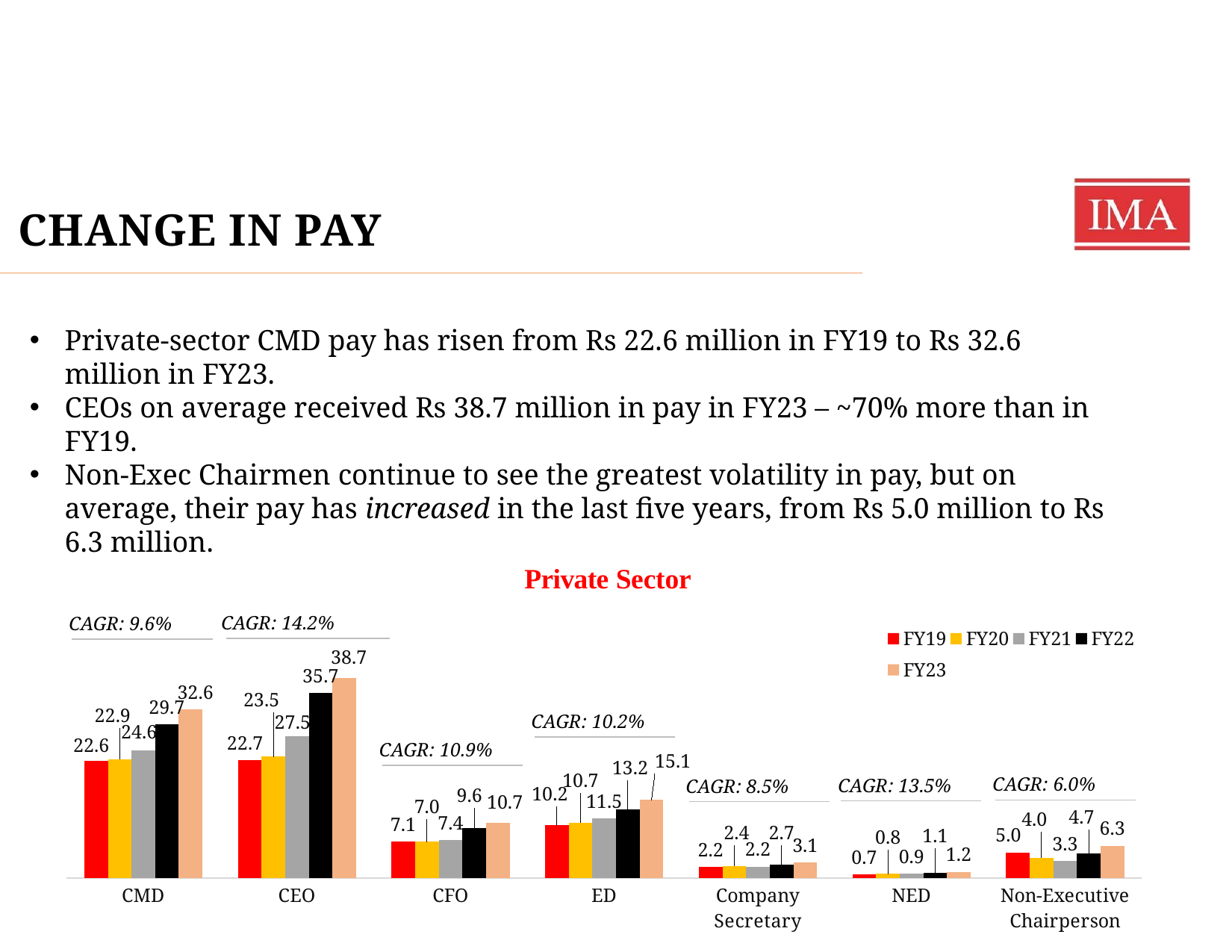
What CAGR is shown above the NED bars in the Private Sector chart? CAGR: 13.5% Which category has the highest FY23 value in the Private Sector chart? CEO What is the FY21 value for Non-Executive Chairperson in the Private Sector chart? 3.3 Which is larger in the Private Sector chart: the FY22 value for CFO or the FY22 value for ED? ED Which category has the lowest FY19 value in the Private Sector chart? NED How many series does the legend of the Private Sector chart list? 5 What type of chart is shown under the title "Private Sector"? Bar chart How many categories are shown on the x axis of the Private Sector chart? 7 What is the difference between the FY23 and FY19 values for ED in the Private Sector chart? 4.9 What is the FY23 value for CEO in the Private Sector chart? 38.7 What is the FY19 value for CMD in the Private Sector chart? 22.6 Do the values for CEO rise or fall from FY19 to FY23 in the Private Sector chart? Rise